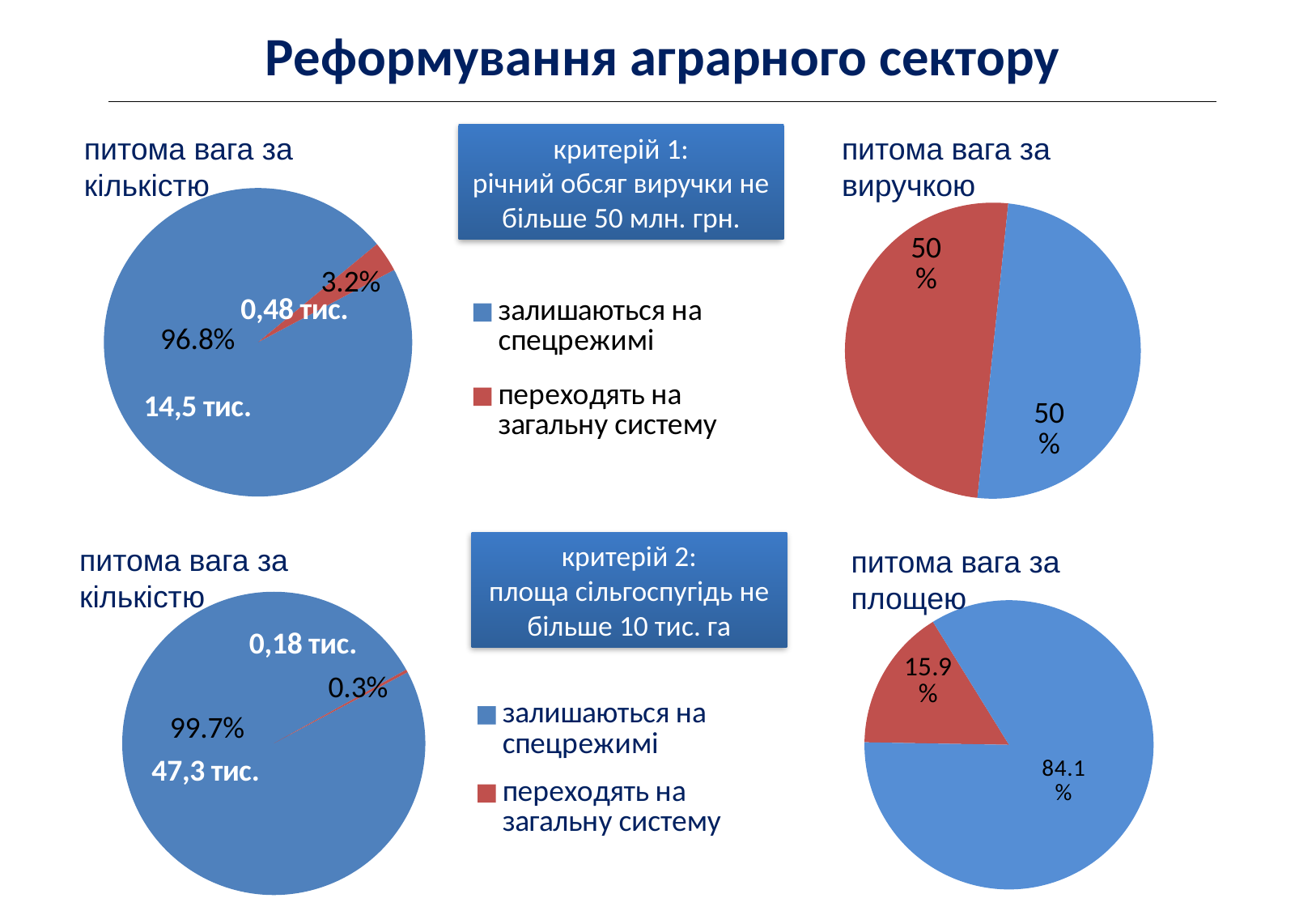
In the bottom-left pie chart (питома вага за кількістю, criterion 2), what share is shown for the red slice 'переходять на загальну систему'? 0.3% What type of chart is used for 'питома вага за виручкою'? pie chart How many entries does the legend next to the top-left pie chart list? 2 In the top-left pie chart (питома вага за кількістю, criterion 1), what count in thousands is labelled on the blue slice 'залишаються на спецрежимі'? 14,5 тис. In the bottom-left pie chart (питома вага за кількістю, criterion 2), what count in thousands is labelled on the blue slice 'залишаються на спецрежимі'? 47,3 тис. In the top-left pie chart (питома вага за кількістю, criterion 1), what count in thousands is labelled on the red slice 'переходять на загальну систему'? 0,48 тис. In the bottom-right pie chart 'питома вага за площею', what is the difference in percentage points between the blue slice (84.1%) and the red slice (15.9%)? 68.2 In the top-left pie chart (питома вага за кількістю, criterion 1), what share is shown for the blue slice 'залишаються на спецрежимі'? 96.8% In the bottom-right pie chart 'питома вага за площею', which slice is larger: 'залишаються на спецрежимі' or 'переходять на загальну систему'? залишаються на спецрежимі In the top-left pie chart (питома вага за кількістю, criterion 1), what share is shown for the red slice 'переходять на загальну систему'? 3.2%